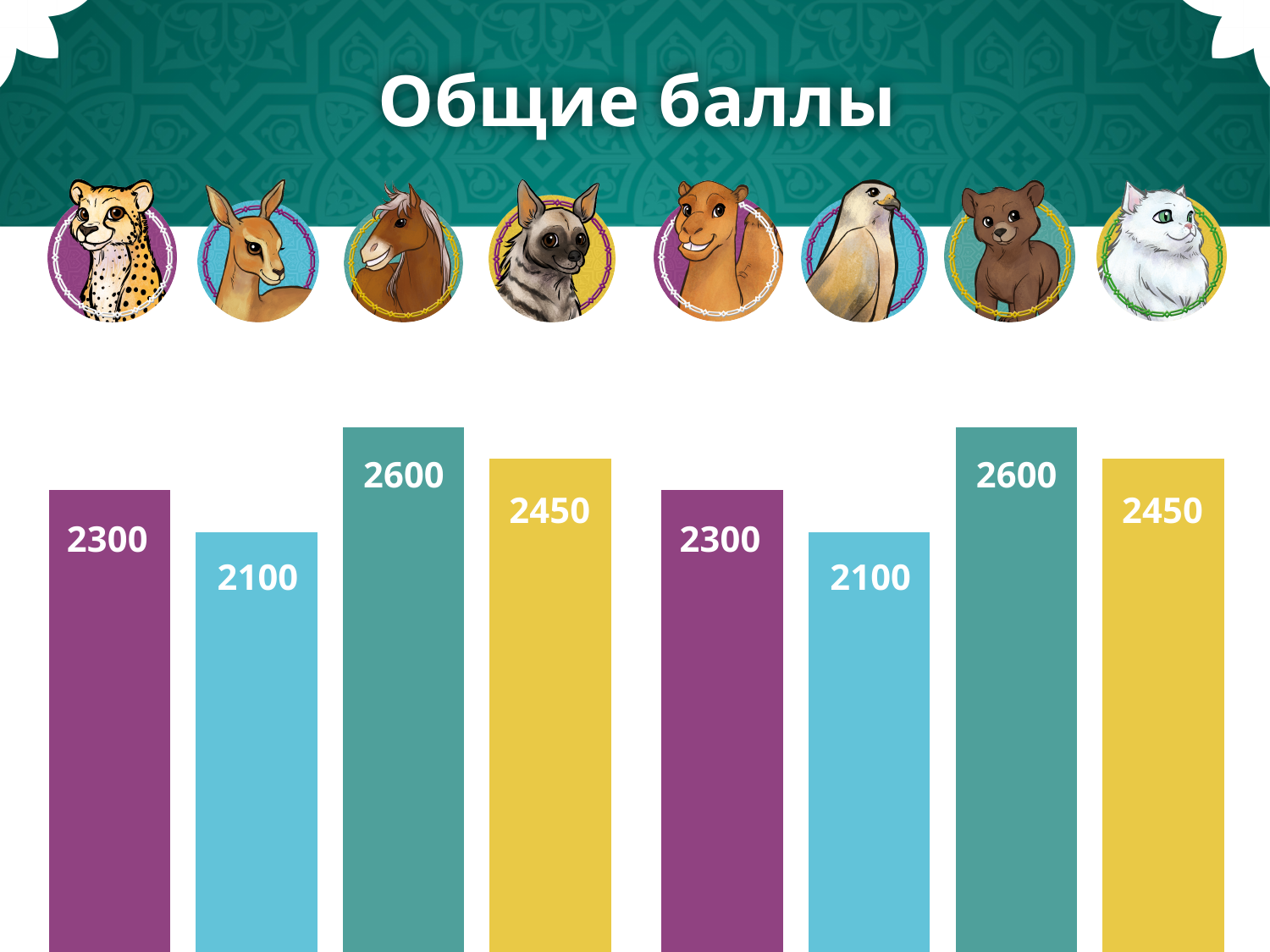
What is the value of the third bar from the left (under the horse)? 2600 What is the difference between the third bar (2600) and the second bar (2100)? 500 What is the title of the chart? Общие баллы What is the value of the last bar on the right (under the cat)? 2450 What is the value of the second bar from the left (under the gazelle)? 2100 What is the value of the first bar from the left (under the cheetah)? 2300 What is the value of the fourth bar from the left (under the hyena)? 2450 What kind of chart is shown on the slide? bar chart What is the lowest value shown on the chart? 2100 What is the highest value shown on the chart? 2600 How many bars does the chart have? 8 Which is larger: the first bar from the left or the fourth bar from the left? the fourth bar (2450)